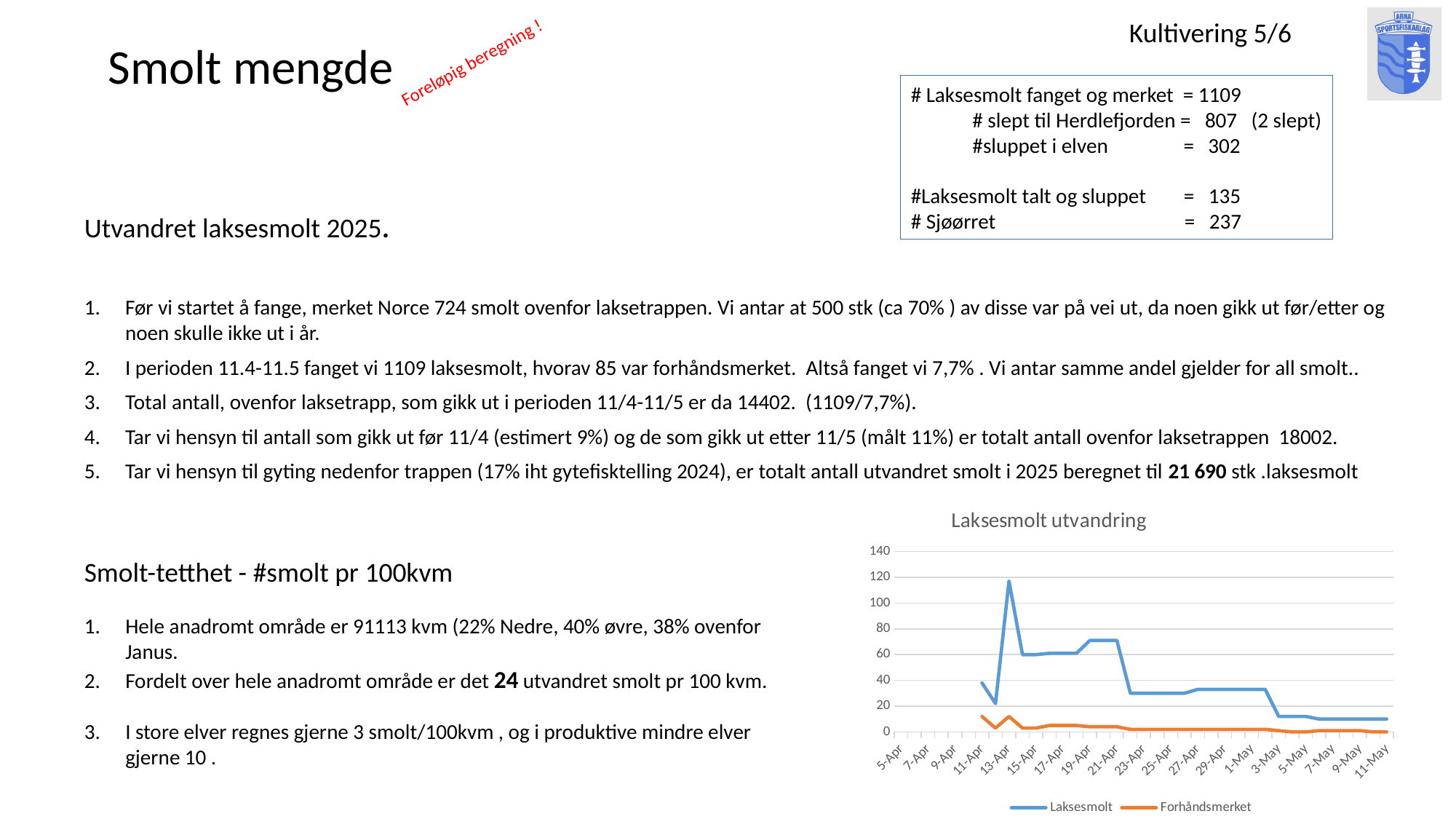
In the 'Laksesmolt utvandring' chart, does the Laksesmolt series rise or fall from 21-Apr to 11-May? fall What are the two series named in the legend of the 'Laksesmolt utvandring' chart? Laksesmolt and Forhåndsmerket In the 'Laksesmolt utvandring' chart, which series has the larger value on 13-Apr, Laksesmolt or Forhåndsmerket? Laksesmolt What is the title of the chart on the slide? Laksesmolt utvandring What kind of chart is 'Laksesmolt utvandring'? line chart In the 'Laksesmolt utvandring' chart, is the Laksesmolt value on 19-Apr greater or less than 60? greater In the 'Laksesmolt utvandring' chart, is the peak value of the Laksesmolt series greater or less than 100? greater In the 'Laksesmolt utvandring' chart, on which date does the Laksesmolt series reach its highest value? 13-Apr How many series does the legend of the 'Laksesmolt utvandring' chart list? 2 What is the highest value shown on the y axis of the 'Laksesmolt utvandring' chart? 140 In the 'Laksesmolt utvandring' chart, is the Laksesmolt value on 11-May greater or less than 20? less